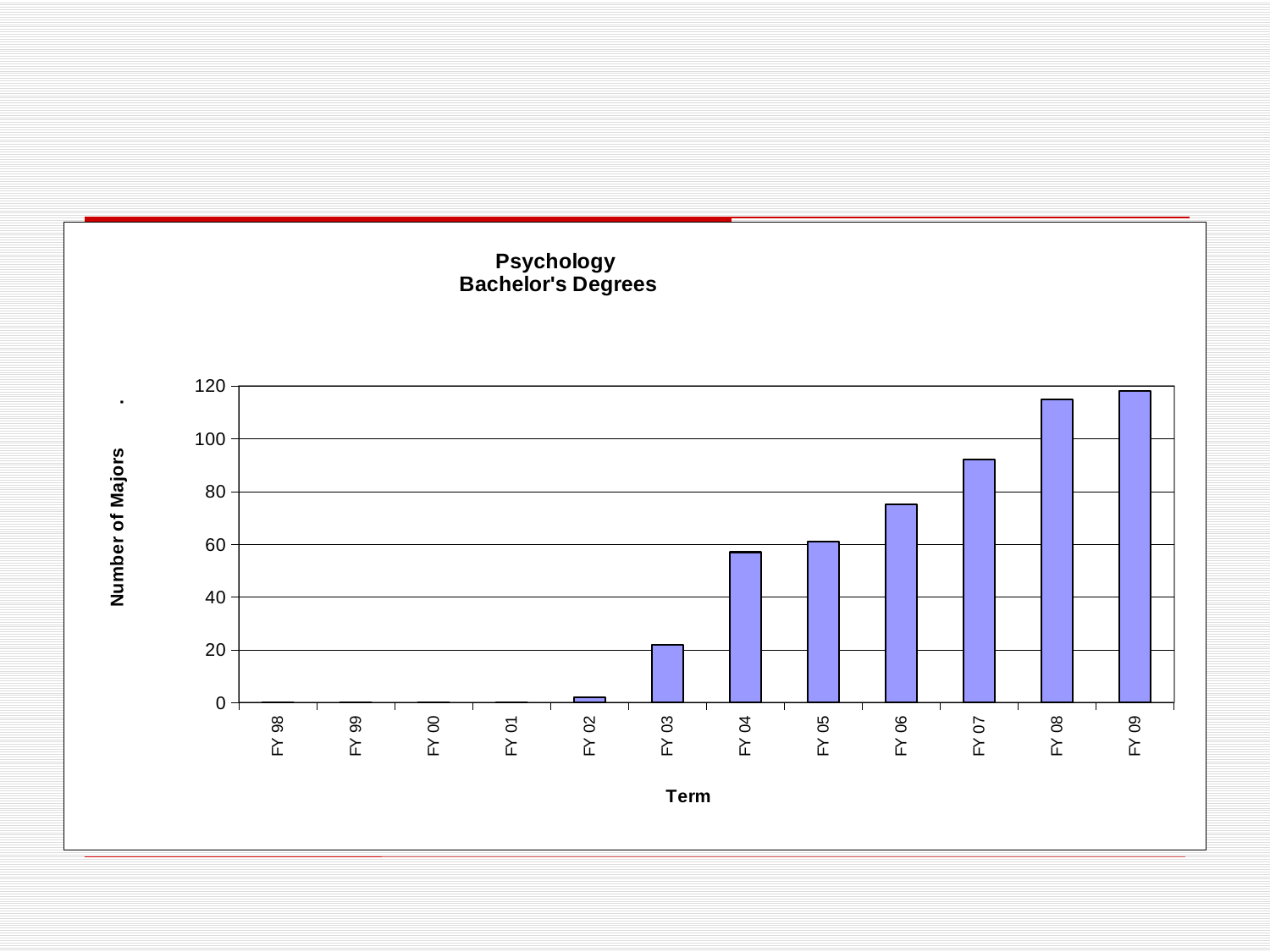
Which is larger, the value for FY 06 or the value for FY 04? FY 06 Which is larger, the value for FY 07 or the value for FY 05? FY 07 Is the value for FY 08 greater or less than 100? greater Is the value for FY 07 greater or less than 80? greater Do the values generally rise or fall from FY 98 to FY 09? rise What kind of chart is shown on the slide? bar chart What is the title of the chart? Psychology Bachelor's Degrees Is the value for FY 03 greater or less than 40? less What is the label on the vertical axis? Number of Majors How many fiscal years (categories) are shown on the x axis? 12